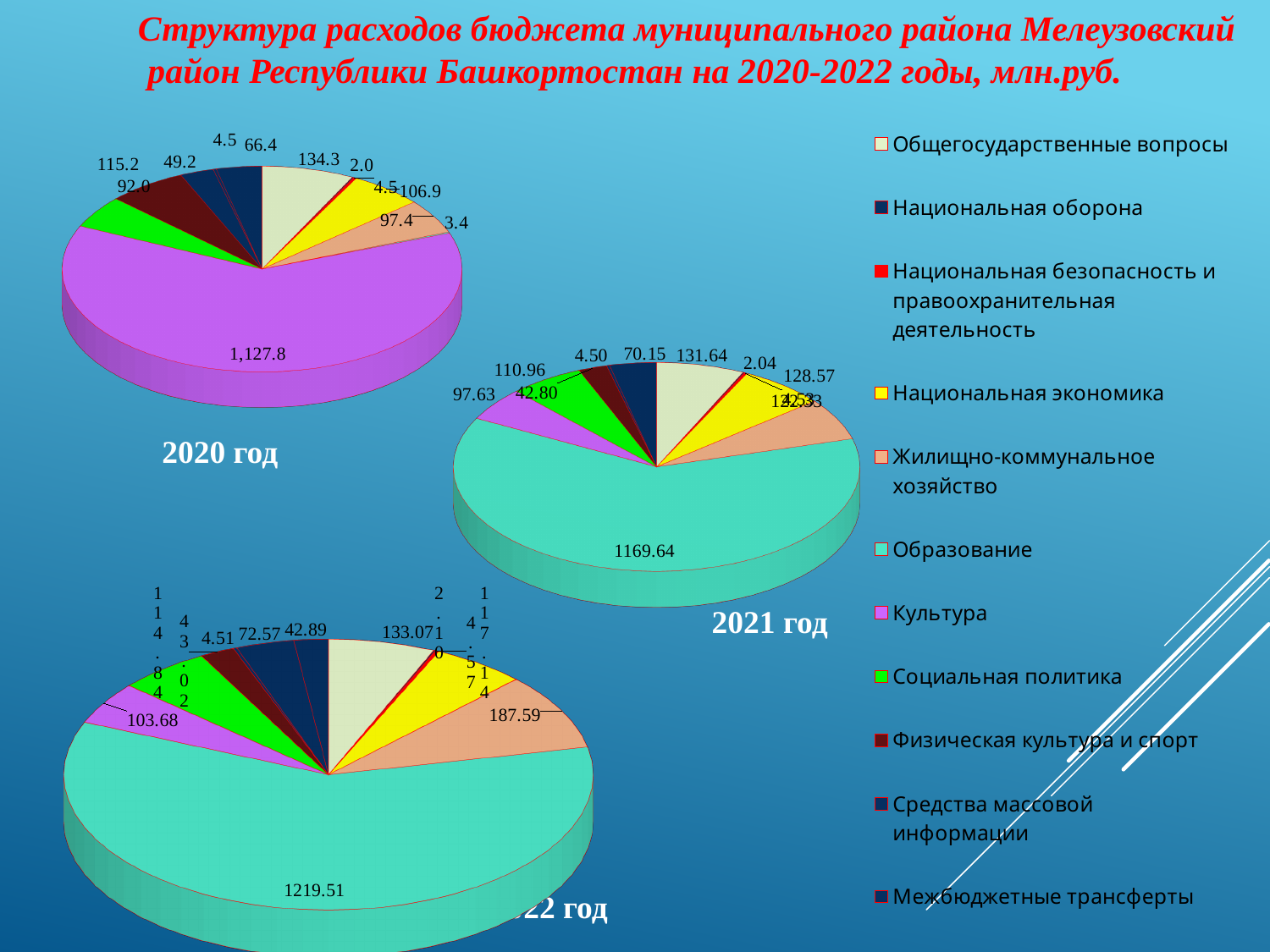
In the 2022 год pie chart, what is the value of the largest slice? 1219.51 Which is larger: the Образование value in the 2021 год chart or in the 2022 год chart? 2022 год In the 2022 год pie chart, what is the value for Жилищно-коммунальное хозяйство? 187.59 How many categories does the legend list? 11 In the 2021 год pie chart, what is the value for Образование? 1169.64 In the 2020 год pie chart, what is the value of the largest slice? 1,127.8 How many pie charts are on the slide? 3 In the 2021 год pie chart, what is the value for Общегосударственные вопросы? 131.64 In the 2022 год pie chart, what is the value for Образование? 1219.51 In the 2021 год pie chart, what is the value of the largest slice? 1169.64 What is the difference between the Образование value in the 2022 год chart and in the 2021 год chart? 49.87 What kind of charts are shown on the slide? Pie charts